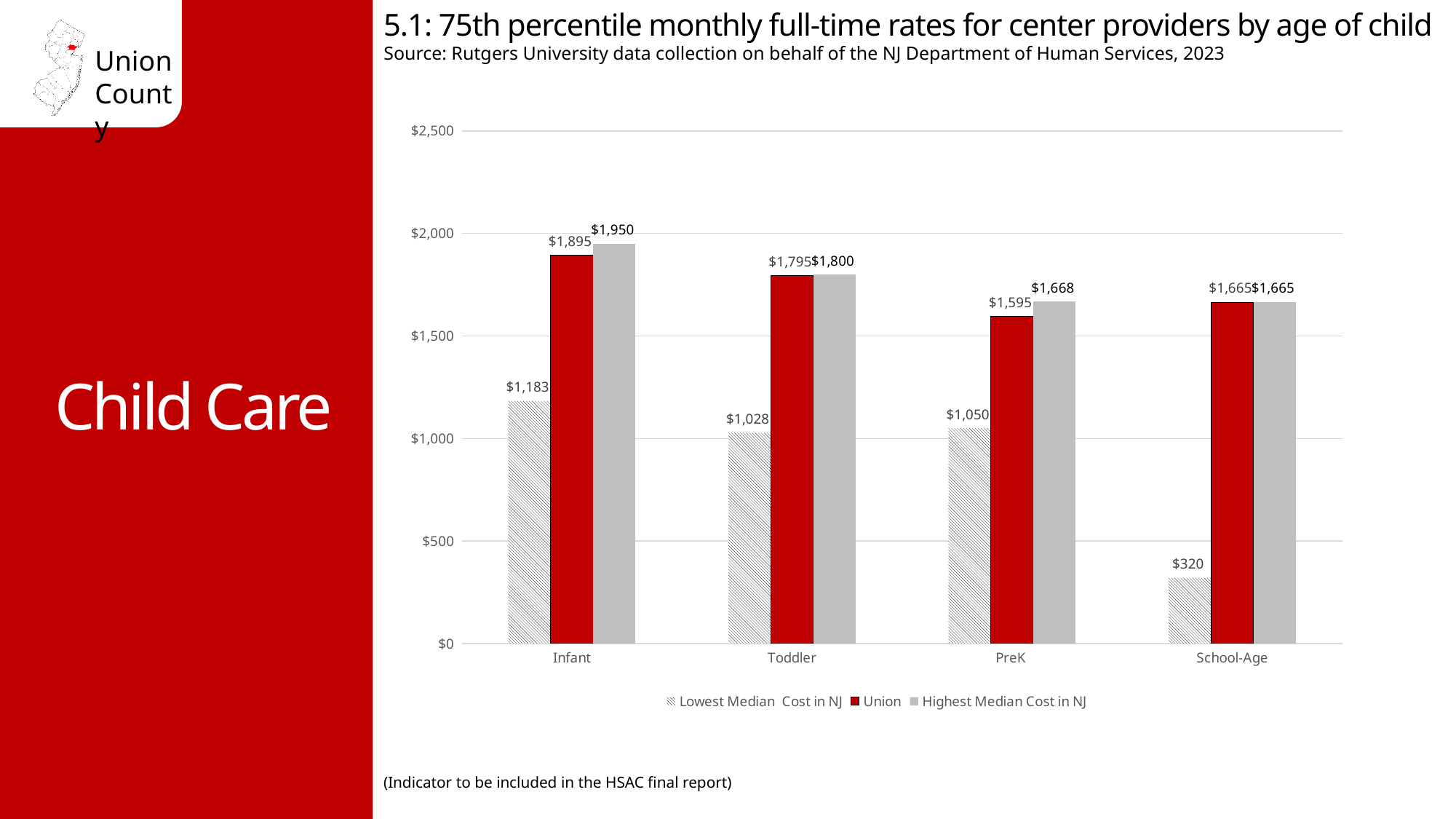
Which age group has the highest Union value? Infant Which age group has the lowest Lowest Median Cost in NJ value? School-Age How many series does the legend list? 3 What kind of chart is shown on the slide? Bar chart What is the Lowest Median Cost in NJ value for School-Age? $320 What is the difference between the Highest Median Cost in NJ and the Lowest Median Cost in NJ for Infant? $767 What is the Union value for Toddler? $1,795 Which is larger for PreK: the Union value or the Lowest Median Cost in NJ value? Union Which series is drawn in red? Union How many age groups are shown on the x axis? 4 What is the Highest Median Cost in NJ value for PreK? $1,668 What is the Union value for Infant? $1,895